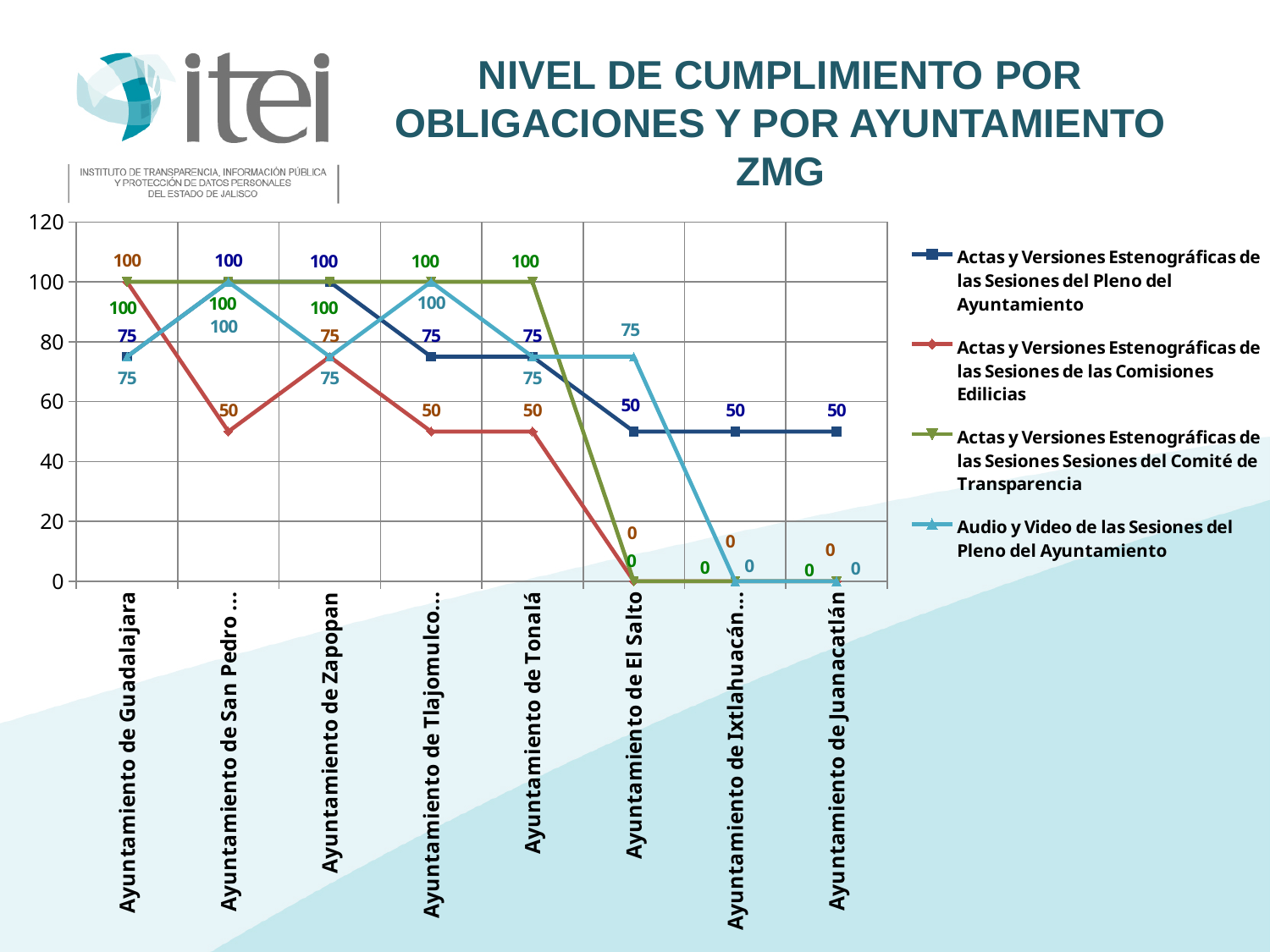
What is the title of the chart? NIVEL DE CUMPLIMIENTO POR OBLIGACIONES Y POR AYUNTAMIENTO ZMG For Ayuntamiento de Zapopan, which is larger: the 'Pleno del Ayuntamiento' value or the 'Comisiones Edilicias' value? Pleno del Ayuntamiento What is the value for Ayuntamiento de El Salto in the series 'Audio y Video de las Sesiones del Pleno del Ayuntamiento'? 75 How many series does the legend list? 4 What is the difference between the 'Comité de Transparencia' value and the 'Comisiones Edilicias' value for Ayuntamiento de Tlajomulco? 50 What is the value for Ayuntamiento de Guadalajara in the series 'Actas y Versiones Estenográficas de las Sesiones del Pleno del Ayuntamiento'? 75 What is the value for Ayuntamiento de Tonalá in the series 'Actas y Versiones Estenográficas de las Sesiones Sesiones del Comité de Transparencia'? 100 How many ayuntamientos (categories) are plotted along the x axis? 8 Does the 'Actas y Versiones Estenográficas de las Sesiones Sesiones del Comité de Transparencia' series rise or fall from Ayuntamiento de Tonalá to Ayuntamiento de El Salto? fall What kind of chart is shown on the slide? line chart What is the value for Ayuntamiento de Juanacatlán in the series 'Actas y Versiones Estenográficas de las Sesiones del Pleno del Ayuntamiento'? 50